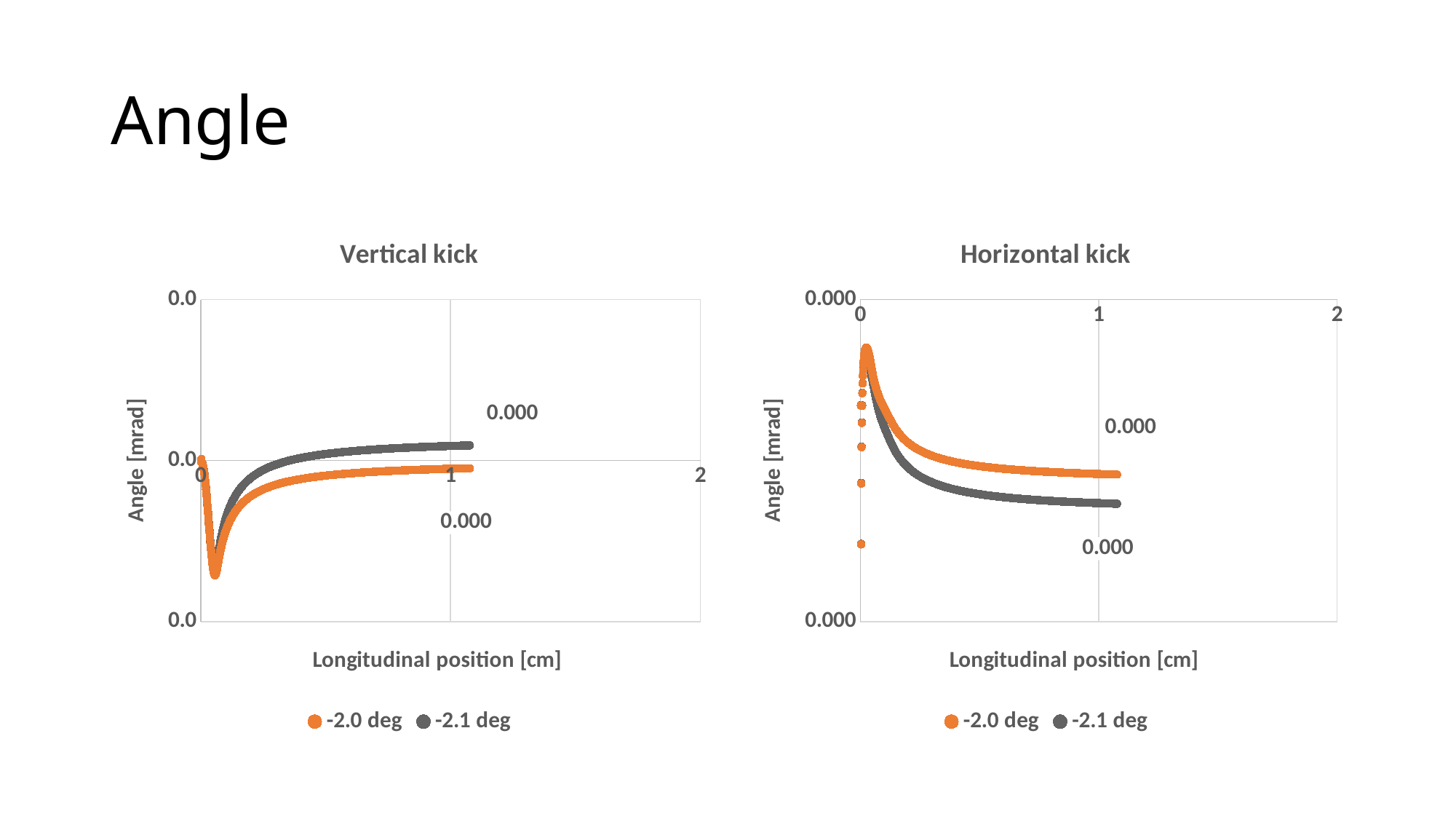
In the Horizontal kick chart, what is the y-axis title? Angle [mrad] What is the title of the right chart? Horizontal kick What is the title of the left chart? Vertical kick In the Vertical kick chart, which series has the higher angle at a longitudinal position of 1 cm, -2.0 deg or -2.1 deg? -2.1 deg In the Horizontal kick chart, which series has the higher angle at a longitudinal position of 1 cm, -2.0 deg or -2.1 deg? -2.0 deg In the Horizontal kick chart, how many series does the legend list? 2 In the Horizontal kick chart, do the values of the -2.1 deg series rise or fall as longitudinal position increases beyond the initial peak? Fall In the Horizontal kick chart, what kind of chart is shown? Scatter chart In the Vertical kick chart, what kind of chart is shown? Scatter chart In the Vertical kick chart, do the values of the -2.0 deg series rise or fall as longitudinal position increases after the initial dip? Rise In the Vertical kick chart, how many series does the legend list? 2